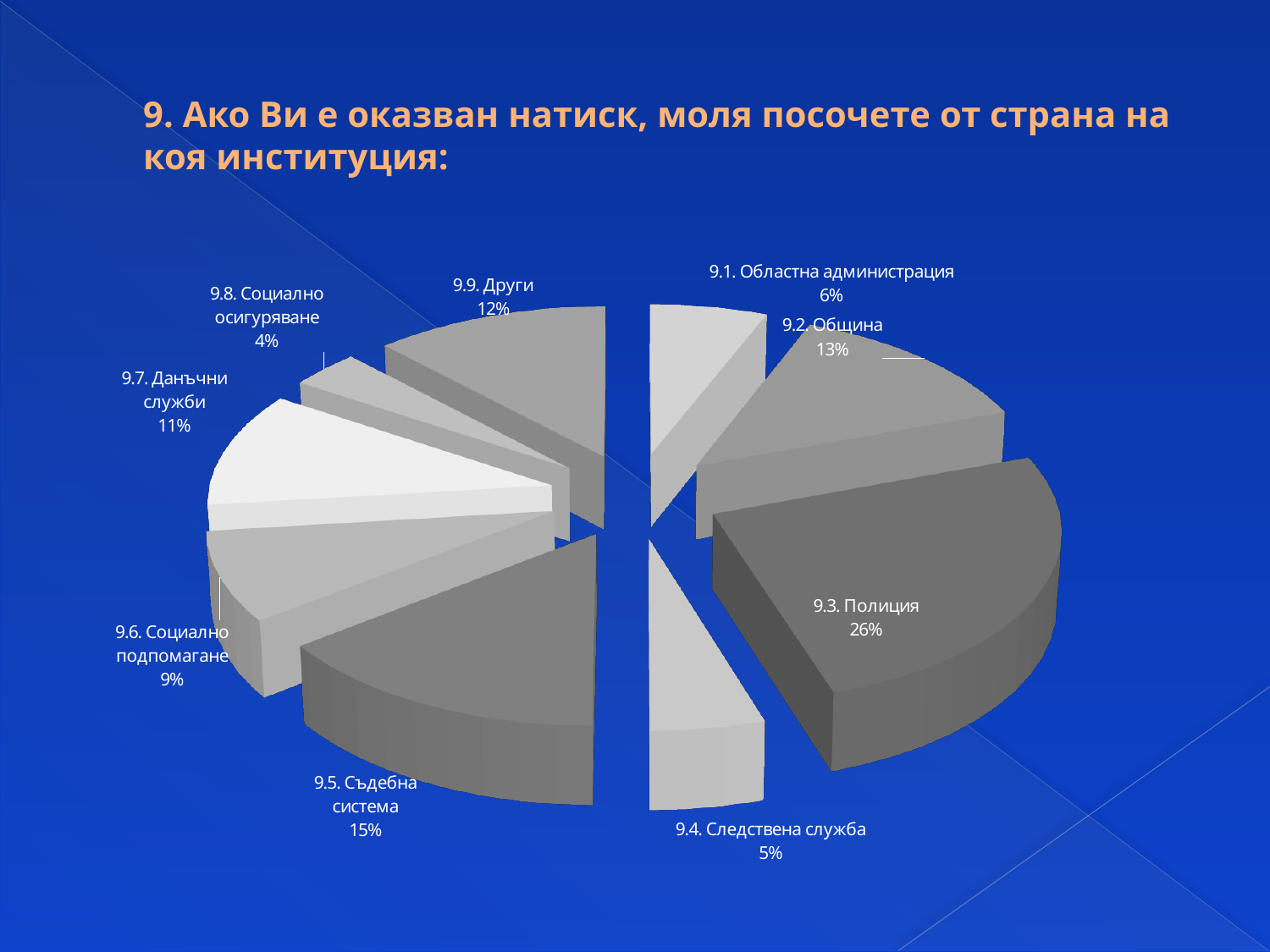
What is the title of the slide above the chart? 9. Ако Ви е оказван натиск, моля посочете от страна на коя институция: What percentage is shown for 9.2. Община? 13% Which category has the largest share of the pie? 9.3. Полиция What is the difference in percentage points between 9.3. Полиция and 9.5. Съдебна система? 11 How many slices does the pie chart have? 9 What percentage is shown for 9.5. Съдебна система? 15% What kind of chart is shown on the slide? Pie chart What percentage is shown for 9.7. Данъчни служби? 11% What share of the pie does 9.3. Полиция have? 26% Which is larger, the share for 9.9. Други or the share for 9.6. Социално подпомагане? 9.9. Други What is the difference in percentage points between 9.1. Областна администрация and 9.4. Следствена служба? 1 Which category has the smallest share of the pie? 9.8. Социално осигуряване